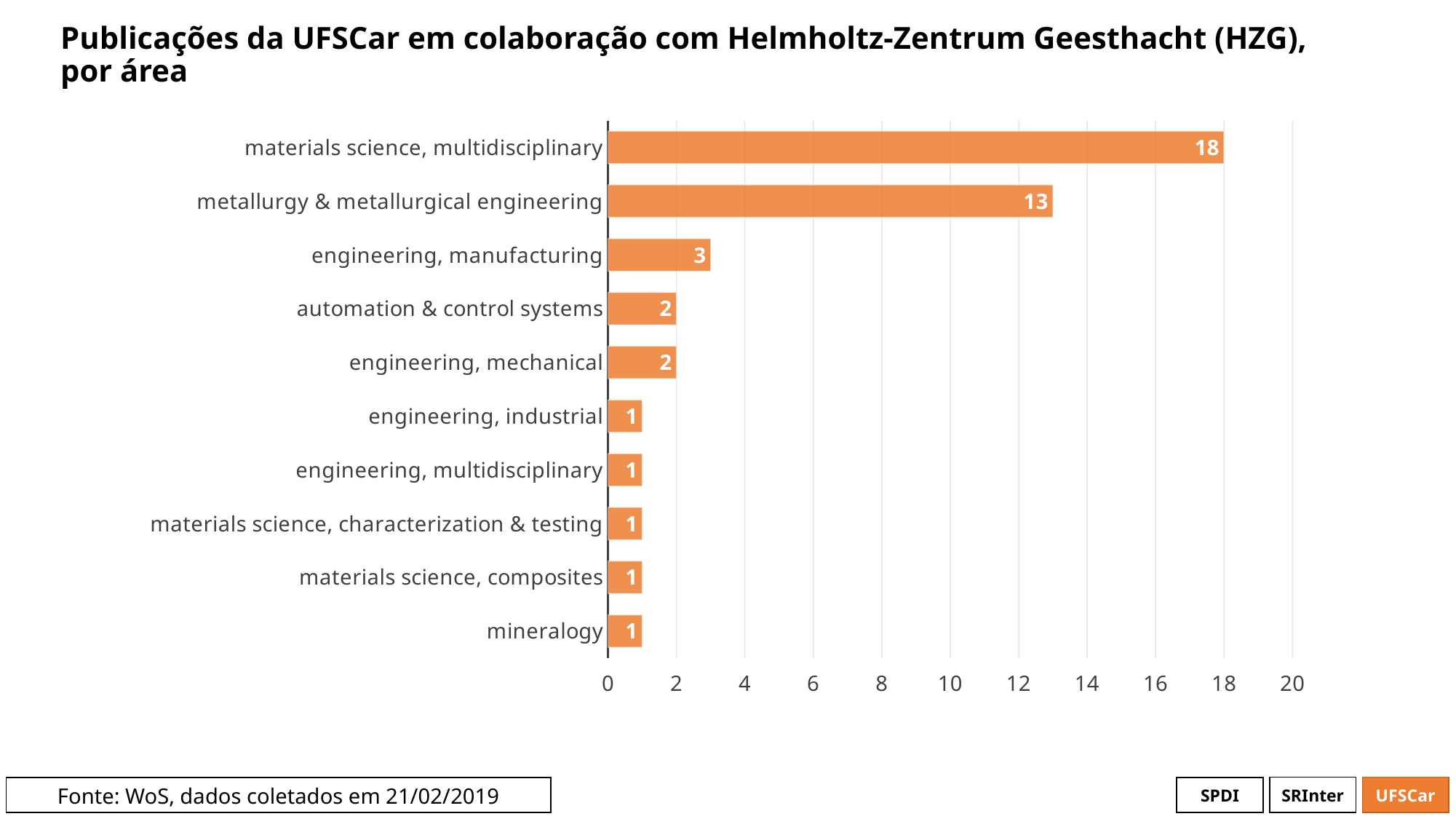
What kind of chart is shown on the slide? bar chart Is the value for metallurgy & metallurgical engineering greater or less than 10? greater What is the title of the chart? Publicações da UFSCar em colaboração com Helmholtz-Zentrum Geesthacht (HZG), por área What is the difference between materials science, multidisciplinary and metallurgy & metallurgical engineering? 5 What is the value for mineralogy? 1 What is the value for automation & control systems? 2 What is the value for engineering, manufacturing? 3 How many areas are shown in the chart? 10 Which area has the highest value? materials science, multidisciplinary What is the value for materials science, multidisciplinary? 18 What is the value for metallurgy & metallurgical engineering? 13 Which is larger, engineering, manufacturing or engineering, mechanical? engineering, manufacturing